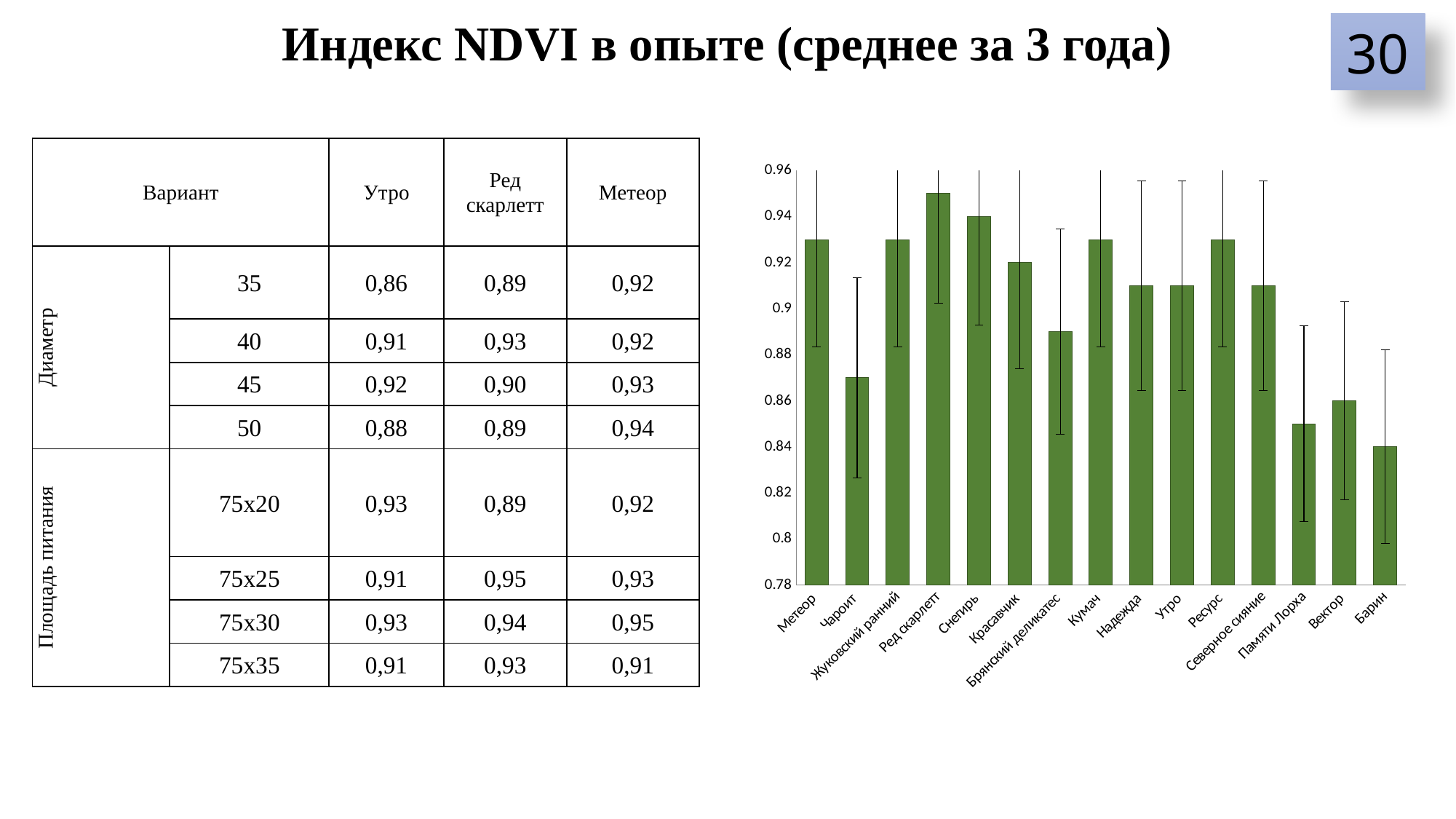
What kind of chart is shown on the slide? bar chart Is the value for Ред скарлетт greater or less than 0.92? greater Is the value for Снегирь greater or less than 0.92? greater Is the value for Чароит greater or less than 0.9? less Which variety has the lowest bar on the chart? Барин Which has the larger value on the chart, Метеор or Чароит? Метеор Which has the larger value on the chart, Вектор or Барин? Вектор Which variety has the highest bar on the chart? Ред скарлетт What colour are the bars on the chart? green How many varieties (categories) are plotted on the chart? 15